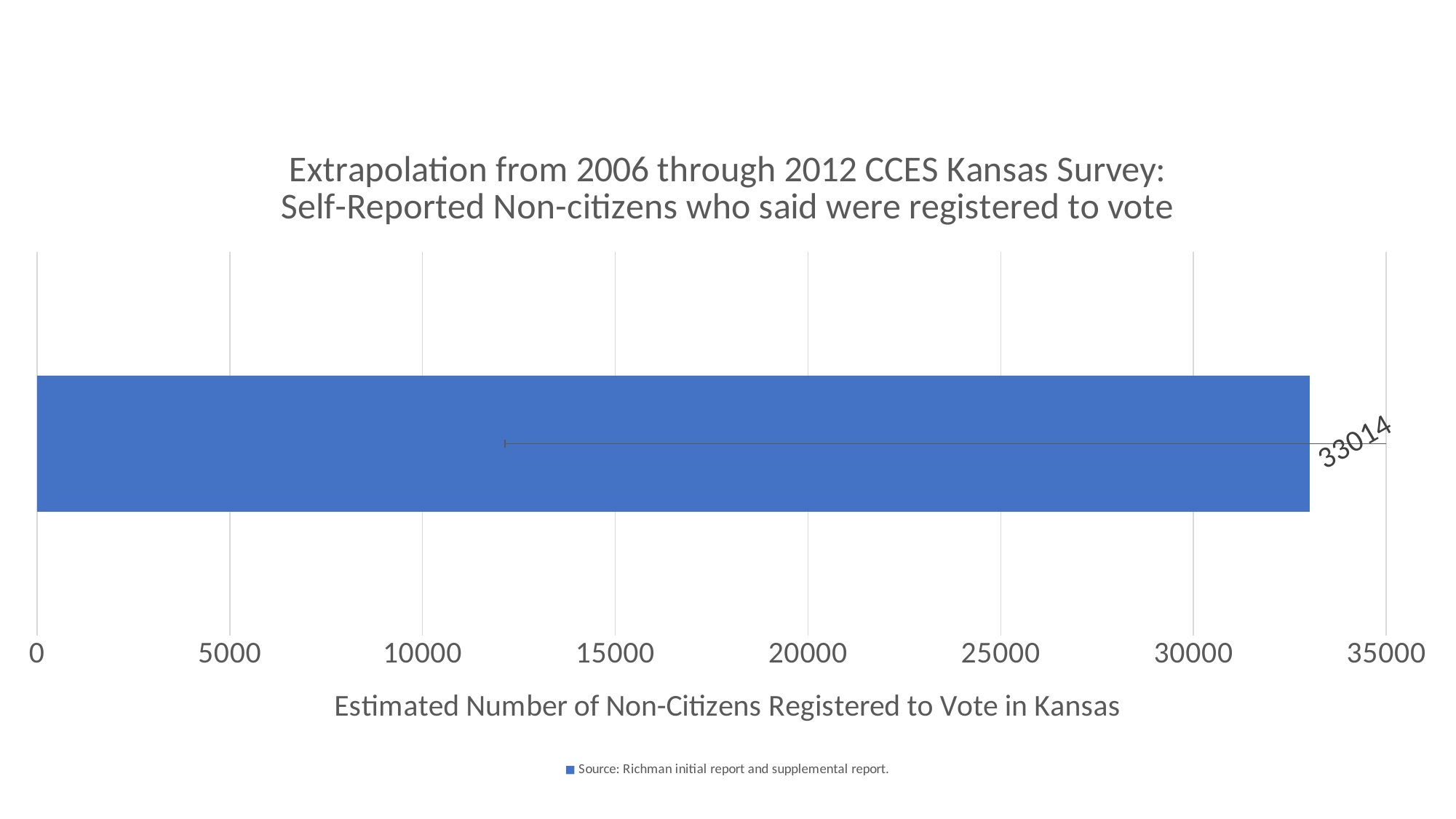
How many series does the legend list? 1 What is the title of the horizontal axis? Estimated Number of Non-Citizens Registered to Vote in Kansas Is the value of the bar greater or less than 30000? greater What value is printed on the bar in the chart? 33014 How many bars are plotted in the chart? 1 What kind of chart is shown on the slide? bar chart Is the value of the bar greater or less than 25000? greater What is the highest tick value shown on the horizontal axis? 35000 Is the value of the bar greater or less than 35000? less